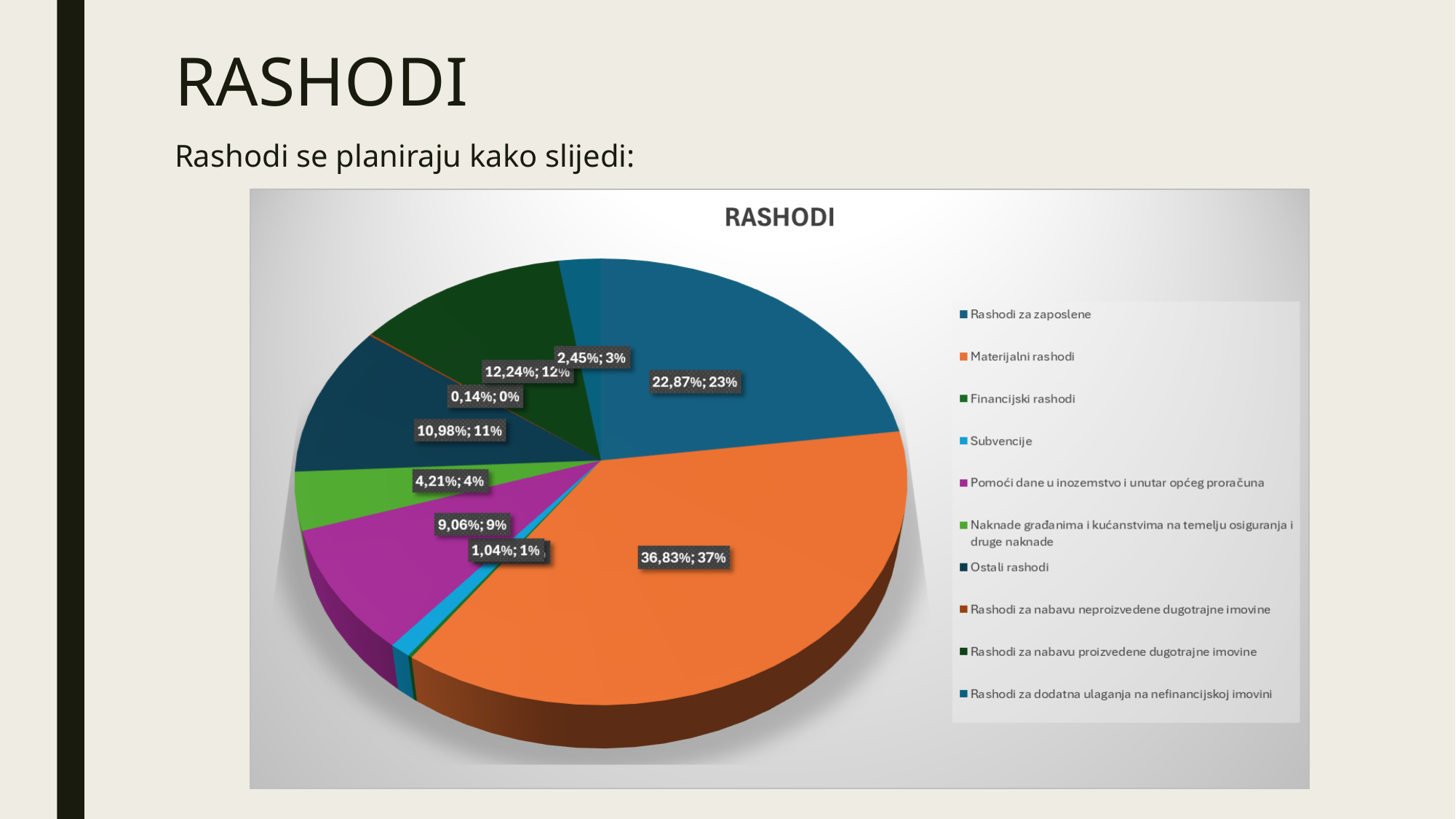
What percentage is shown for Pomoći dane u inozemstvo i unutar općeg proračuna? 9,06% What is the difference in percentage points between Materijalni rashodi and Rashodi za zaposlene? 13,96% What share of the pie is Materijalni rashodi? 36,83% What percentage is shown for Naknade građanima i kućanstvima na temelju osiguranja i druge naknade? 4,21% Which category has the largest slice of the pie? Materijalni rashodi What is the title of the chart? RASHODI Which is larger, the slice for Ostali rashodi or the slice for Pomoći dane u inozemstvo i unutar općeg proračuna? Ostali rashodi What kind of chart is shown on the slide? pie chart What percentage is shown for Subvencije? 1,04% What percentage is shown for Ostali rashodi? 10,98% What share of the pie is Rashodi za zaposlene? 22,87% How many categories does the chart legend list? 10